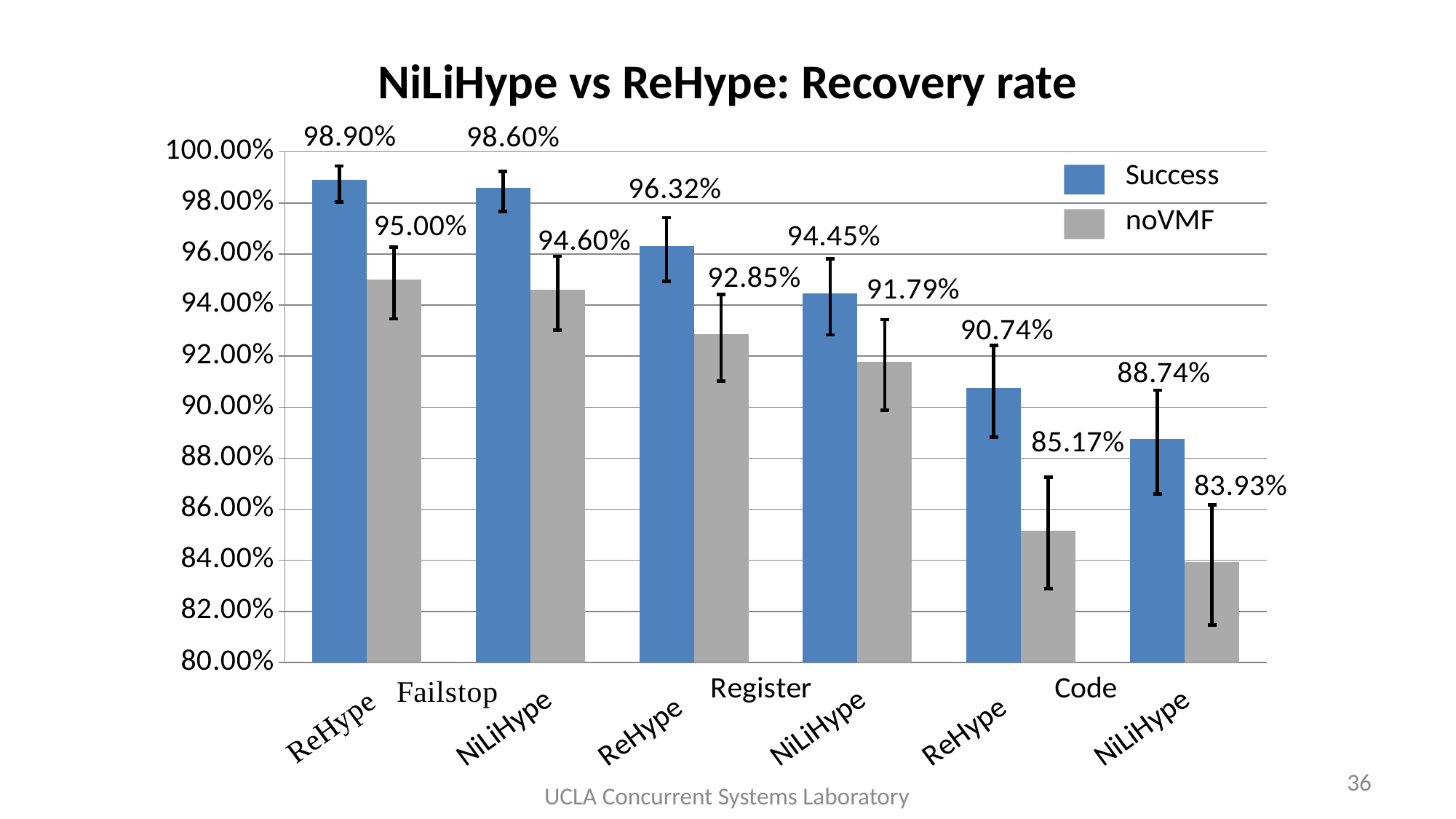
Which category has the lowest noVMF value? NiLiHype (Code) How many series does the legend list? 2 What is the noVMF value for ReHype under Code? 85.17% What is the difference between the Success and noVMF values for ReHype under Register? 3.47% What is the title of the chart? NiLiHype vs ReHype: Recovery rate What kind of chart is shown? Bar chart What is the Success value for NiLiHype under Code? 88.74% What is the Success value for ReHype under Failstop? 98.90% What is the noVMF value for NiLiHype under Register? 91.79% Which category has the highest Success value? ReHype (Failstop) Which is larger, the Success value for NiLiHype under Failstop or the Success value for ReHype under Register? NiLiHype under Failstop How many category groups are plotted along the x axis? 6